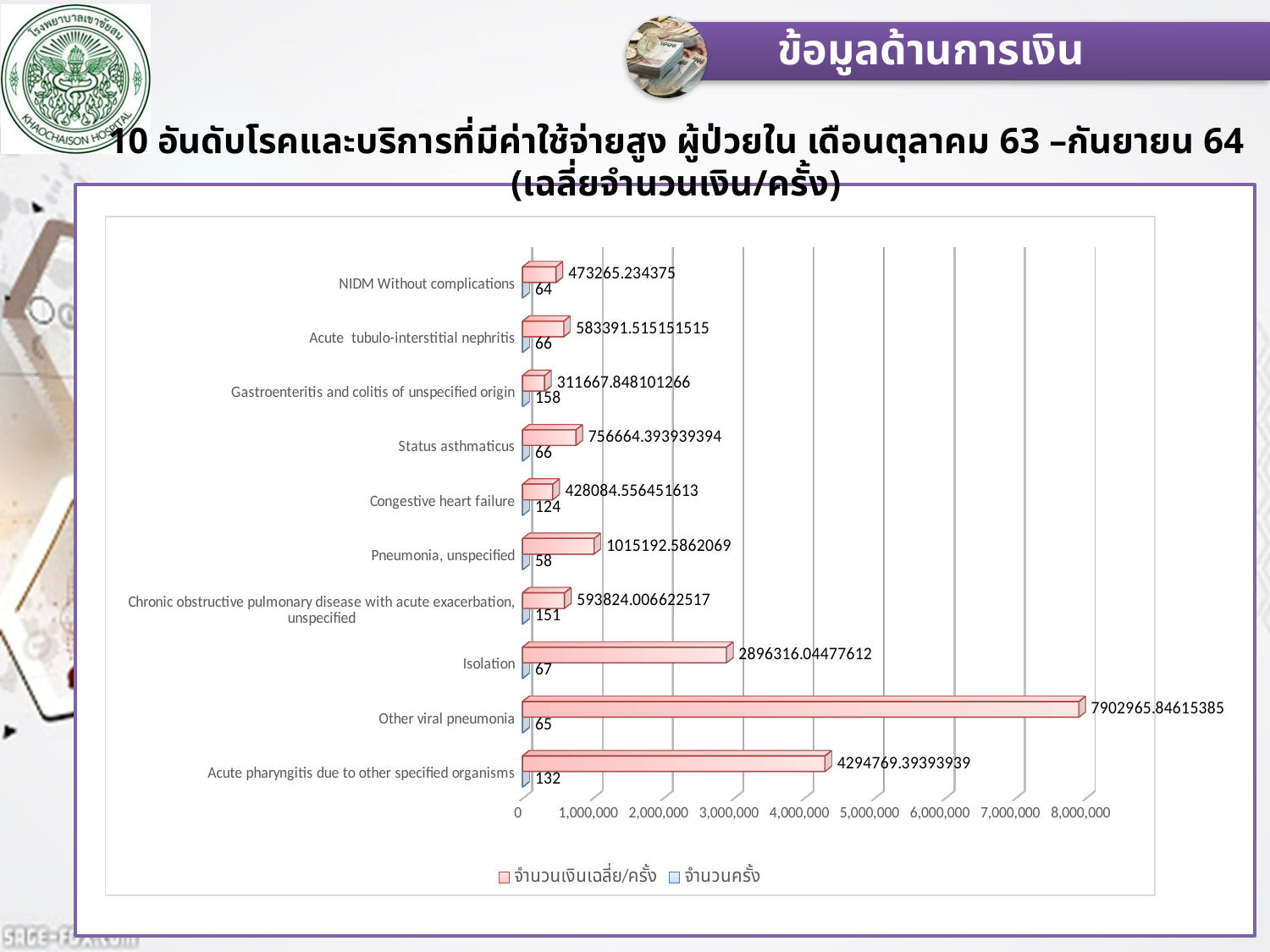
What is the average amount per visit (จำนวนเงินเฉลี่ย/ครั้ง) for Other viral pneumonia? 7902965.84615385 Is the average amount per visit for Acute pharyngitis due to other specified organisms greater or less than 4,000,000? greater Which category has the lowest average amount per visit? Gastroenteritis and colitis of unspecified origin Which category has the highest average amount per visit? Other viral pneumonia What is the average amount per visit for Isolation? 2896316.04477612 How many series does the legend list? 2 What kind of chart is shown on the slide? Bar chart What is the number of visits (จำนวนครั้ง) for Gastroenteritis and colitis of unspecified origin? 158 What is the difference in number of visits between Gastroenteritis and colitis of unspecified origin and Pneumonia, unspecified? 100 Which has a larger average amount per visit: Status asthmaticus or Congestive heart failure? Status asthmaticus How many categories are shown in the chart? 10 Which category has the lowest number of visits (จำนวนครั้ง)? Pneumonia, unspecified